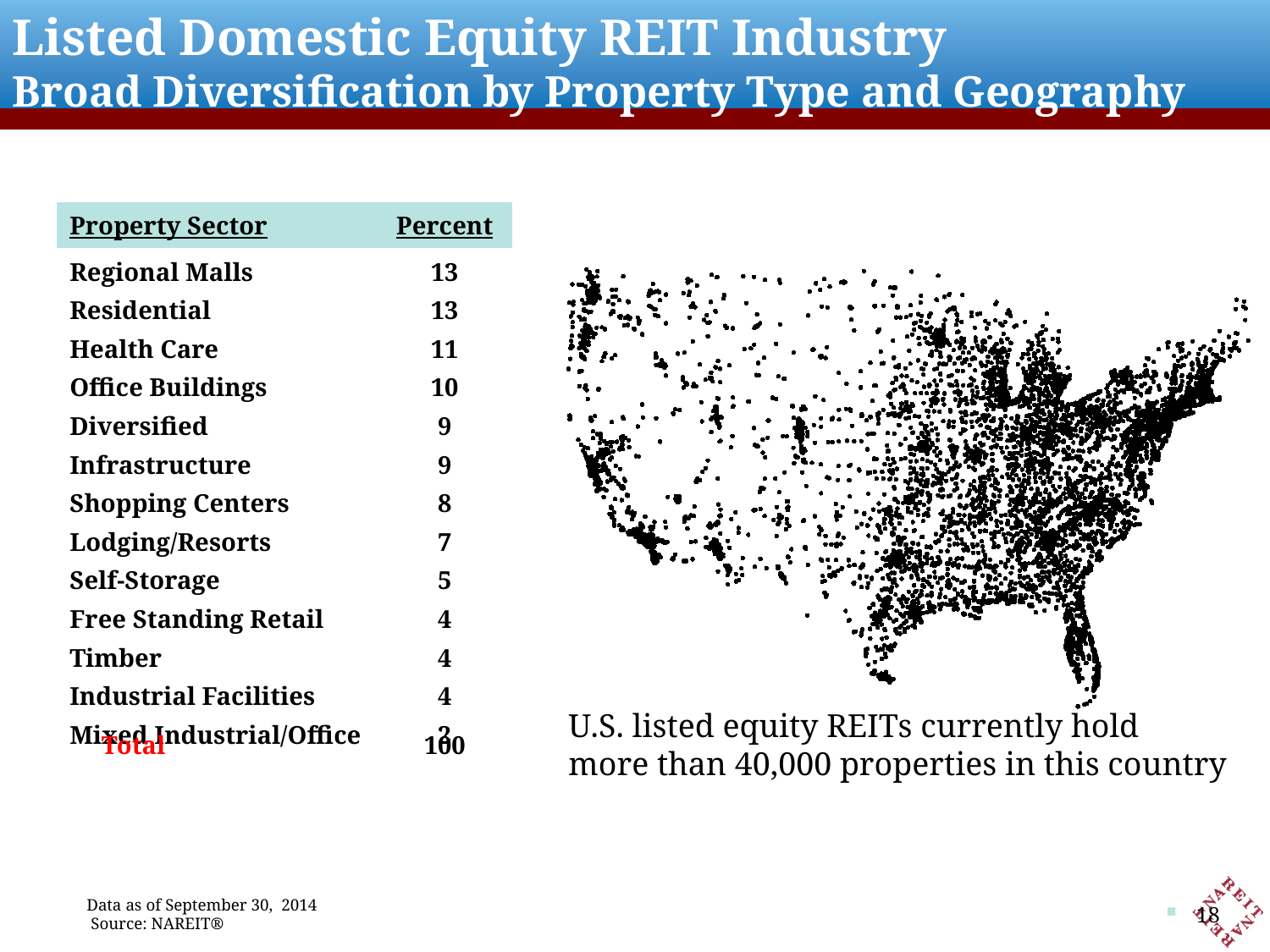
In the Property Sector table, what is the difference in percent between Office Buildings and Free Standing Retail? 6 In the Property Sector table, what is the percent for Office Buildings? 10 In the Property Sector table, what is the percent for Regional Malls? 13 In the Property Sector table, which has a higher percent, Timber or Lodging/Resorts? Lodging/Resorts In the Property Sector table, what is the percent for Lodging/Resorts? 7 According to the footnote, what is the 'data as of' date for the slide? September 30, 2014 In the Property Sector table, what is the difference in percent between Regional Malls and Self-Storage? 8 In the Property Sector table, what is the percent for Shopping Centers? 8 How many property sectors are listed in the table on the left? 13 In the Property Sector table, what is the percent for Health Care? 11 In the Property Sector table, what is the percent for Self-Storage? 5 In the Property Sector table, which has a higher percent, Health Care or Diversified? Health Care